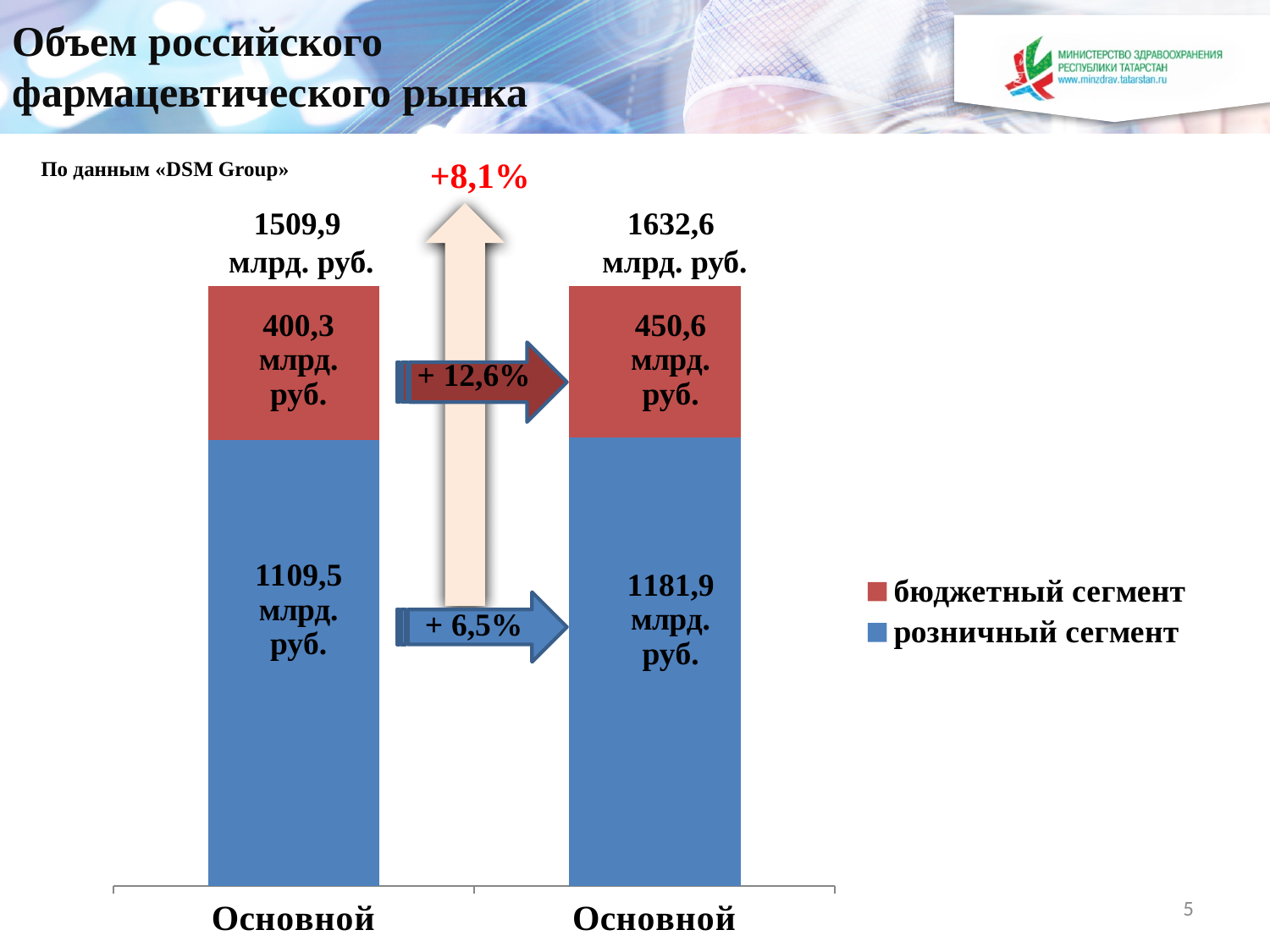
What is the total of the left stacked bar? 1509,9 млрд. руб. Which colour represents the бюджетный сегмент in the legend? red What percentage growth is shown by the arrow between the бюджетный сегмент values? + 12,6% What is the total of the right stacked bar? 1632,6 млрд. руб. What type of chart is shown on the slide? stacked bar chart How many series does the legend list? 2 Which bar has the larger розничный сегмент value, the left or the right? right How many bars are plotted in the chart? 2 Which segment is larger in the left bar, бюджетный сегмент or розничный сегмент? розничный сегмент What is the value of the бюджетный сегмент in the right bar? 450,6 млрд. руб. What is the value of the розничный сегмент in the left bar? 1109,5 млрд. руб. What is the difference between the бюджетный сегмент values of the right bar and the left bar? 50,3 млрд. руб.